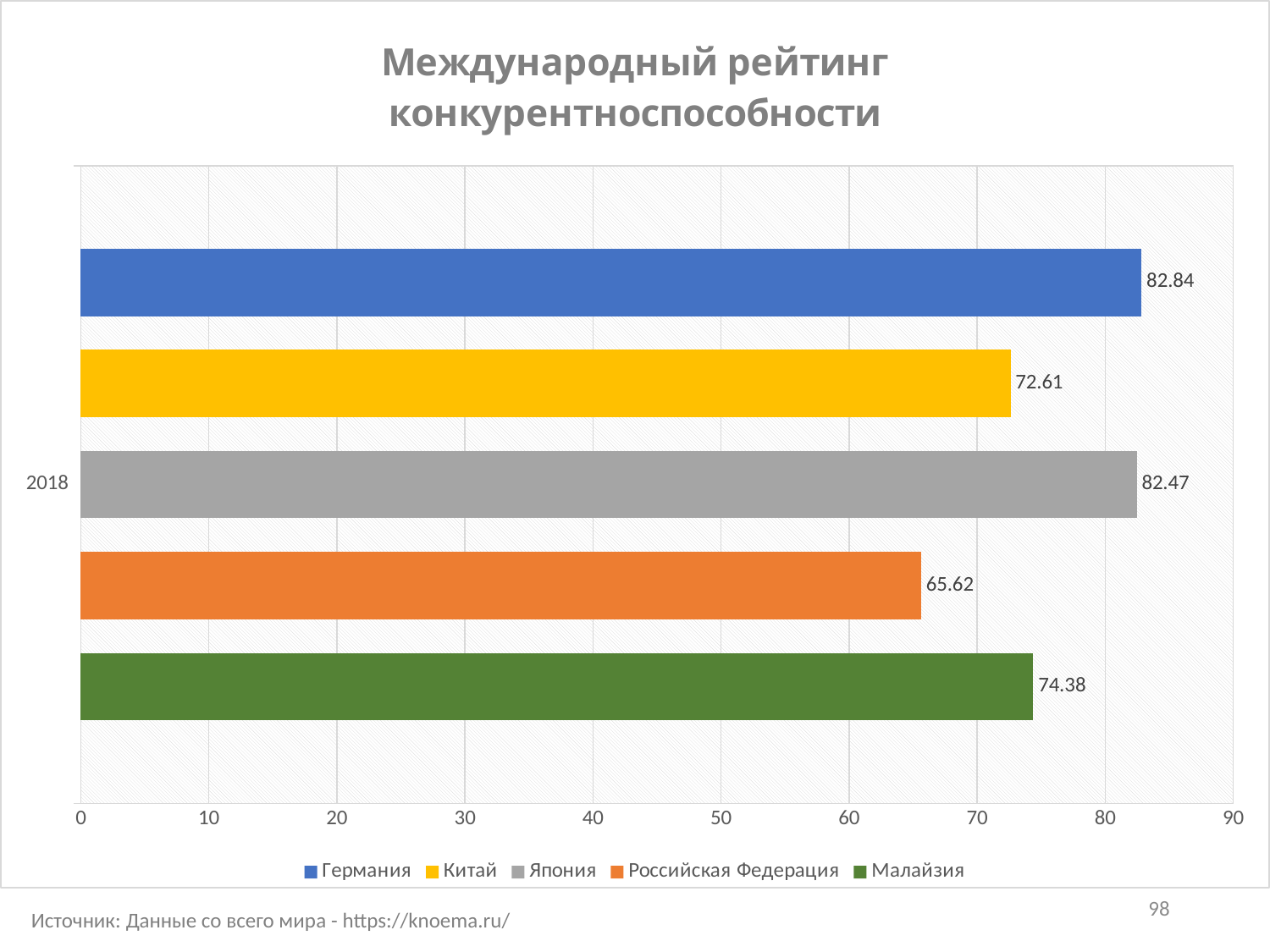
How many series does the legend list? 5 What is the difference between the values for Германия and Российская Федерация? 17.22 What is the value for Германия in 2018? 82.84 What is the title of the chart? Международный рейтинг конкурентноспособности What kind of chart is shown on the slide? Bar chart What is the value for Российская Федерация in 2018? 65.62 What is the value for Малайзия in 2018? 74.38 Which country has the lowest value in 2018? Российская Федерация What is the value for Япония in 2018? 82.47 Which is larger, the value for Малайзия or the value for Китай? Малайзия Which country has the highest value in 2018? Германия What is the value for Китай in 2018? 72.61